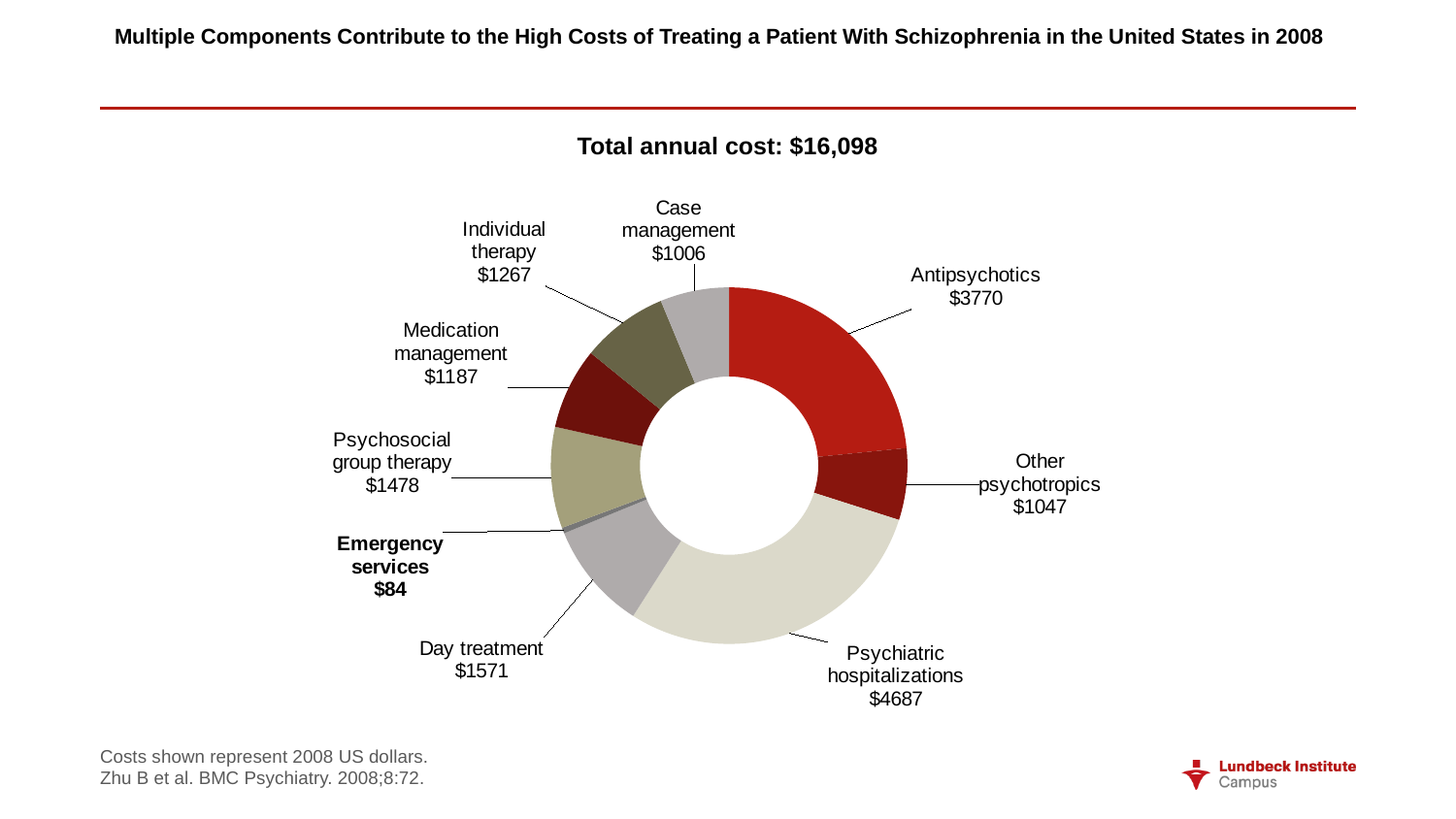
What is the difference between the cost of Psychiatric hospitalizations and the cost of Antipsychotics? $917 What is the difference between the cost of Individual therapy and the cost of Medication management? $80 Which cost component is the smallest? Emergency services Which cost component is the largest? Psychiatric hospitalizations What is the annual cost for Psychiatric hospitalizations? $4687 Which is larger, the cost of Day treatment or the cost of Psychosocial group therapy? Day treatment What is the annual cost for Antipsychotics? $3770 What is the annual cost for Emergency services? $84 What is the annual cost for Day treatment? $1571 What kind of chart is shown on the slide? doughnut chart How many cost components are shown in the chart? 9 What total annual cost is stated above the chart? $16,098